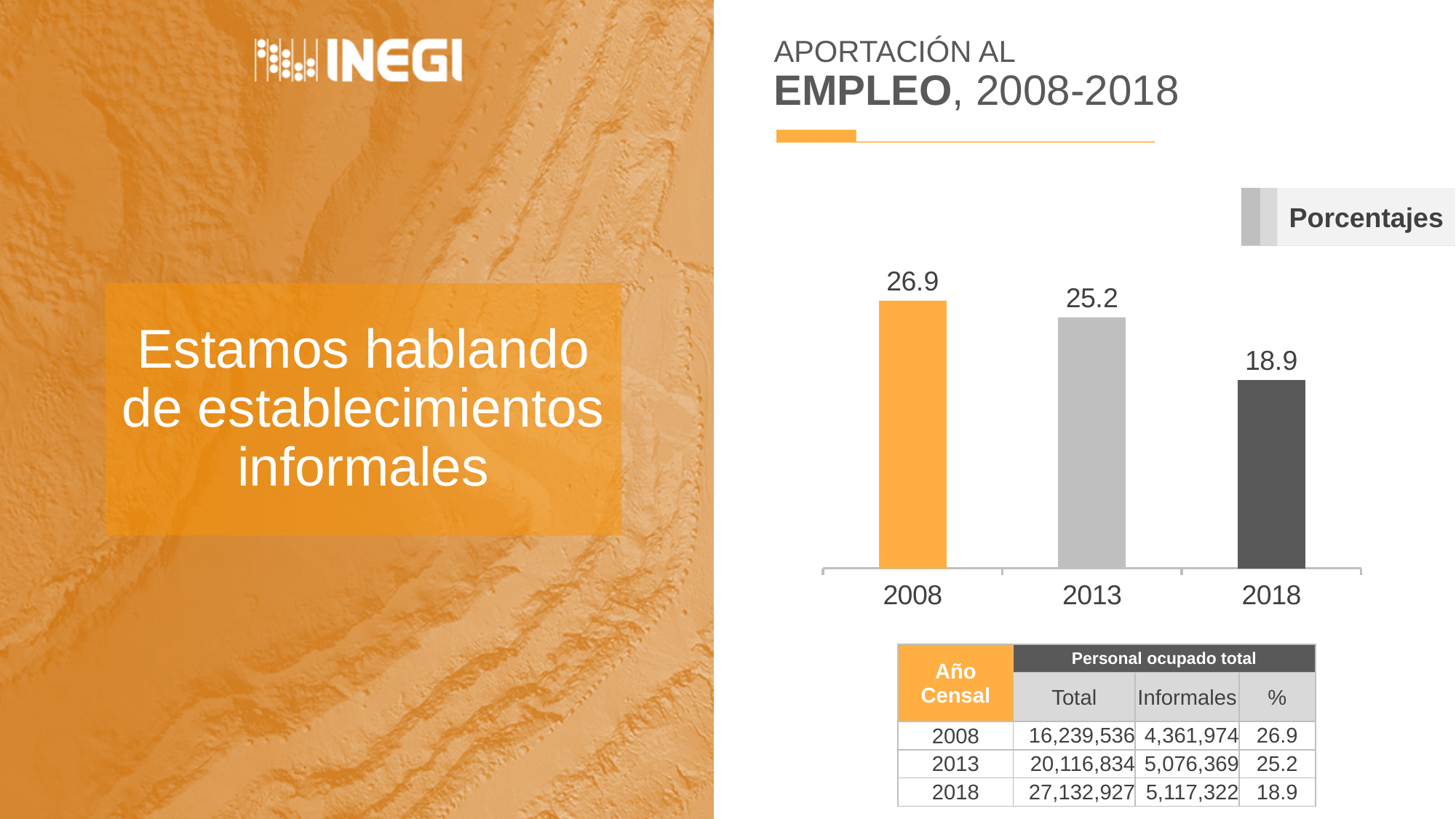
What kind of chart is shown on the slide? bar chart Which is larger, the value for 2008 or the value for 2013? 2008 How many years are shown in the chart? 3 Do the values rise or fall from 2008 to 2018? fall What is the value for 2008 in the chart? 26.9 Which year has the lowest value in the chart? 2018 Which year has the highest value in the chart? 2008 What is the difference between the values for 2013 and 2018? 6.3 What label appears in the legend box at the top right of the chart? Porcentajes What is the value for 2018 in the chart? 18.9 What is the value for 2013 in the chart? 25.2 What is the difference between the values for 2008 and 2018? 8.0